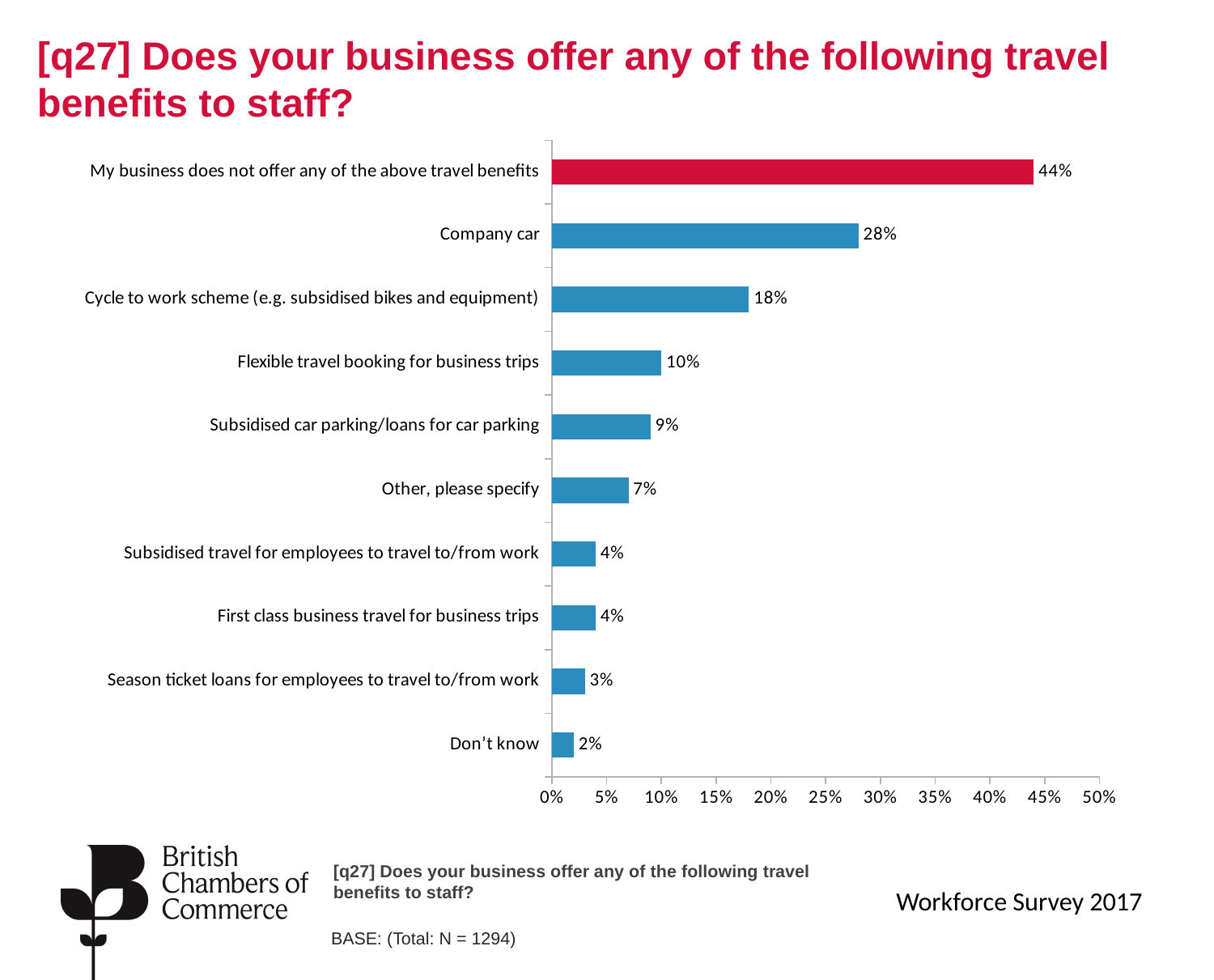
Which is larger: 'Flexible travel booking for business trips' or 'Subsidised car parking/loans for car parking'? Flexible travel booking for business trips What percentage of businesses offer season ticket loans for employees to travel to/from work? 3% Is the value for 'My business does not offer any of the above travel benefits' greater or less than 40%? greater Which category has the lowest value? Don't know What is the difference between the values for 'Other, please specify' and 'Don't know'? 5% What percentage of businesses offer a company car? 28% What is the difference between the values for 'Company car' and 'Cycle to work scheme (e.g. subsidised bikes and equipment)'? 10% Which category has the highest value? My business does not offer any of the above travel benefits Which bar is coloured differently (red) from the others? My business does not offer any of the above travel benefits What is the value for 'Cycle to work scheme (e.g. subsidised bikes and equipment)'? 18% How many categories are shown in the chart? 10 What kind of chart is shown on the slide? Bar chart